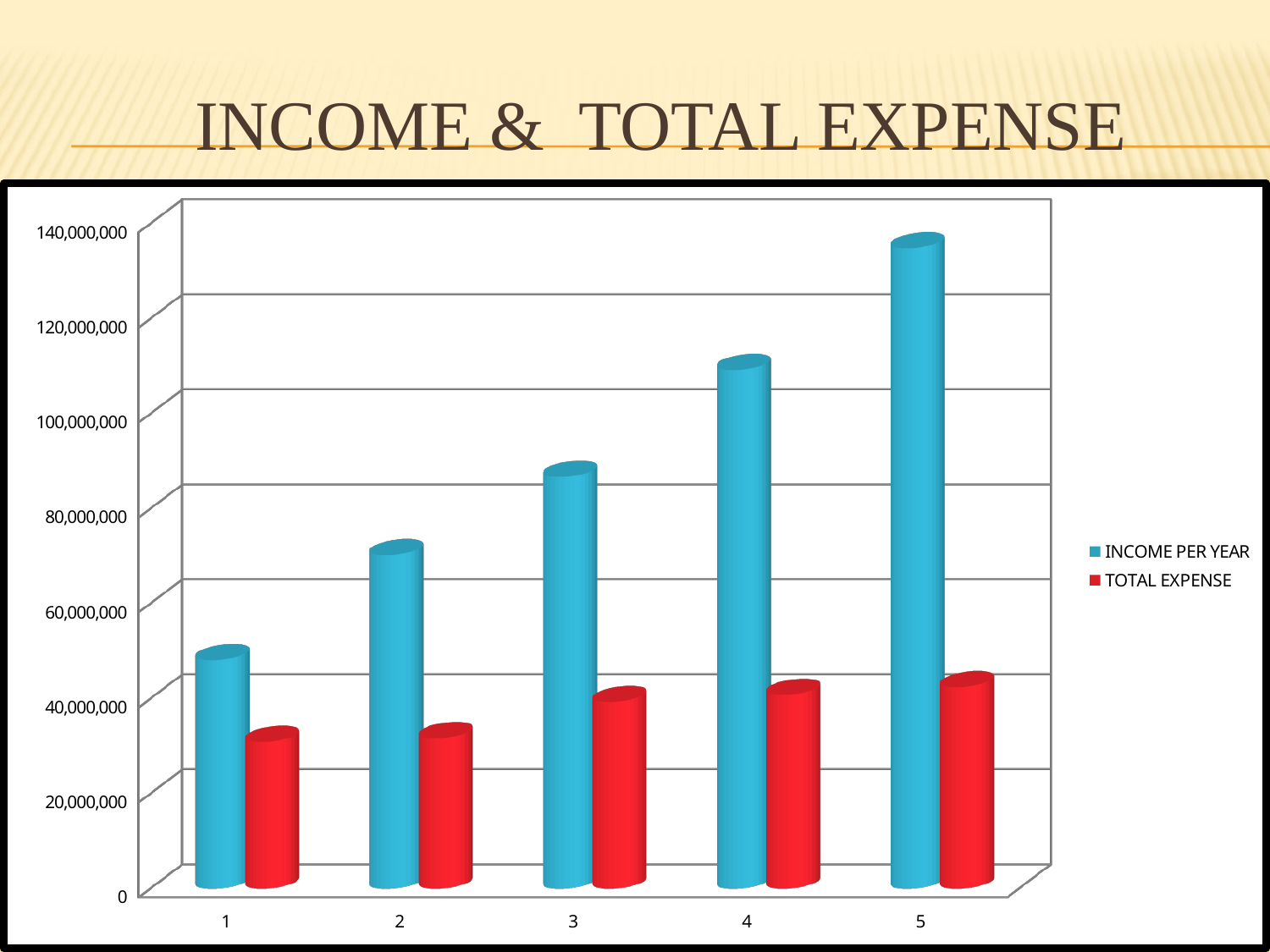
Is the TOTAL EXPENSE value for category 1 greater or less than 40,000,000? less Which category has the lowest INCOME PER YEAR? 1 How many categories are shown on the x axis? 5 Which colour represents the TOTAL EXPENSE series? red Which category has the highest INCOME PER YEAR? 5 How many series does the legend list? 2 What kind of chart is shown on the slide? bar chart Is the INCOME PER YEAR value for category 5 greater or less than 120,000,000? greater Is the INCOME PER YEAR value for category 1 greater or less than 60,000,000? less For category 3, which is larger: INCOME PER YEAR or TOTAL EXPENSE? INCOME PER YEAR What is the title of the chart? INCOME & TOTAL EXPENSE Does INCOME PER YEAR rise or fall from category 1 to category 5? rise